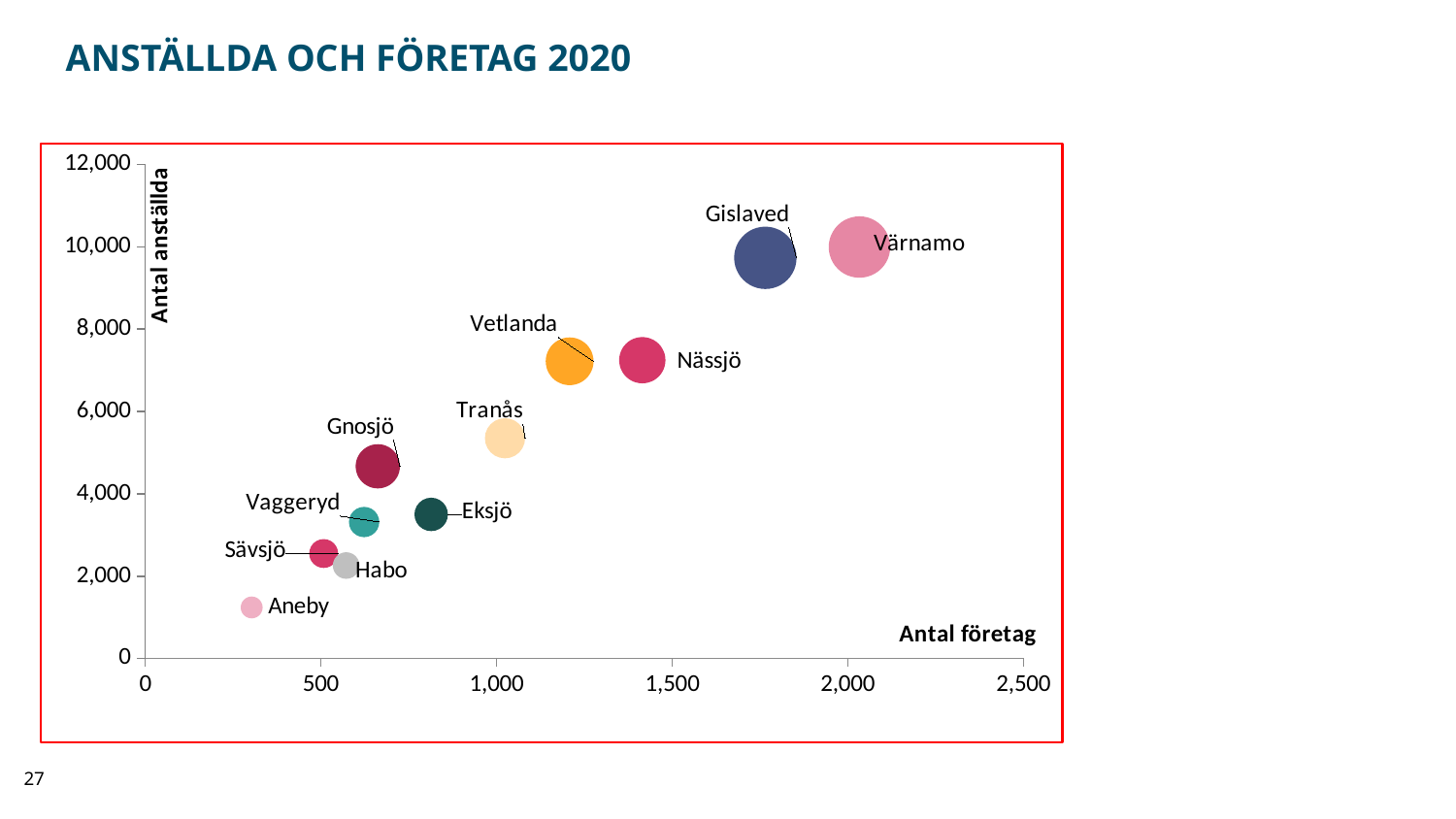
Which municipality has the highest number of employees (Antal anställda)? Värnamo Which municipality has the lowest number of companies (Antal företag)? Aneby Is the number of employees (Antal anställda) for Gnosjö greater or less than 4,000? greater How many municipalities are plotted on the chart? 11 What is the label of the vertical axis? Antal anställda Which has more employees (Antal anställda), Tranås or Gnosjö? Tranås Is the number of companies (Antal företag) for Gislaved greater or less than 2,000? less Which has more companies (Antal företag), Nässjö or Vetlanda? Nässjö What kind of chart is shown on the slide? Bubble chart Is the number of employees (Antal anställda) for Nässjö greater or less than 8,000? less What is the title of the chart? ANSTÄLLDA OCH FÖRETAG 2020